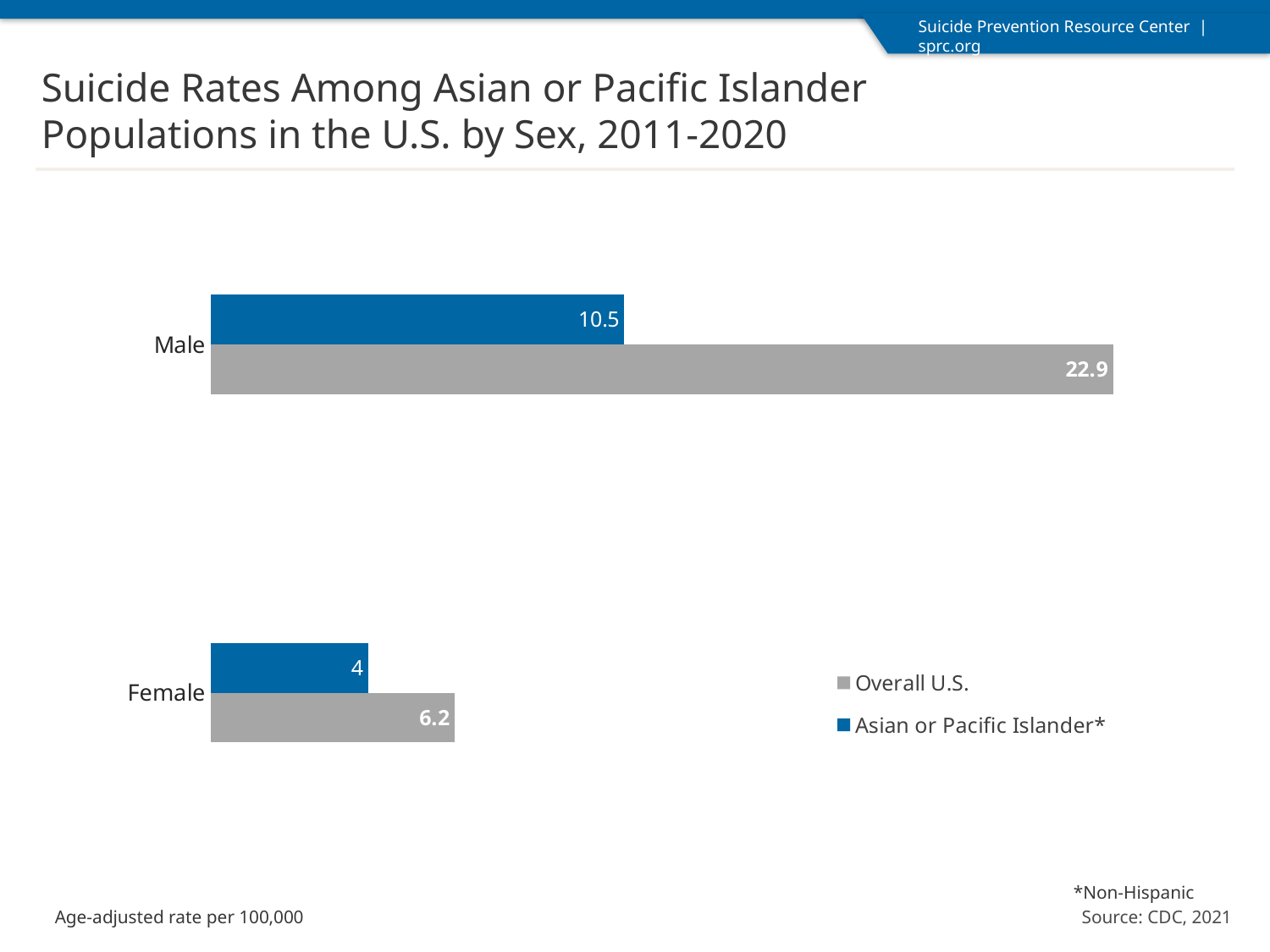
What is the difference between the Overall U.S. male rate and the Asian or Pacific Islander male rate? 12.4 What is the Overall U.S. suicide rate for males? 22.9 Which bar has the highest value on the chart? Overall U.S. Male What is the Overall U.S. suicide rate for females? 6.2 How many series does the legend list? 2 How many categories are shown on the chart? 2 What is the difference between the Overall U.S. female rate and the Asian or Pacific Islander female rate? 2.2 What is the suicide rate for Asian or Pacific Islander females? 4 What kind of chart is shown on the slide? Bar chart Which is larger, the Asian or Pacific Islander male rate or the Overall U.S. female rate? Asian or Pacific Islander male rate Which bar has the lowest value on the chart? Asian or Pacific Islander Female What is the suicide rate for Asian or Pacific Islander males? 10.5